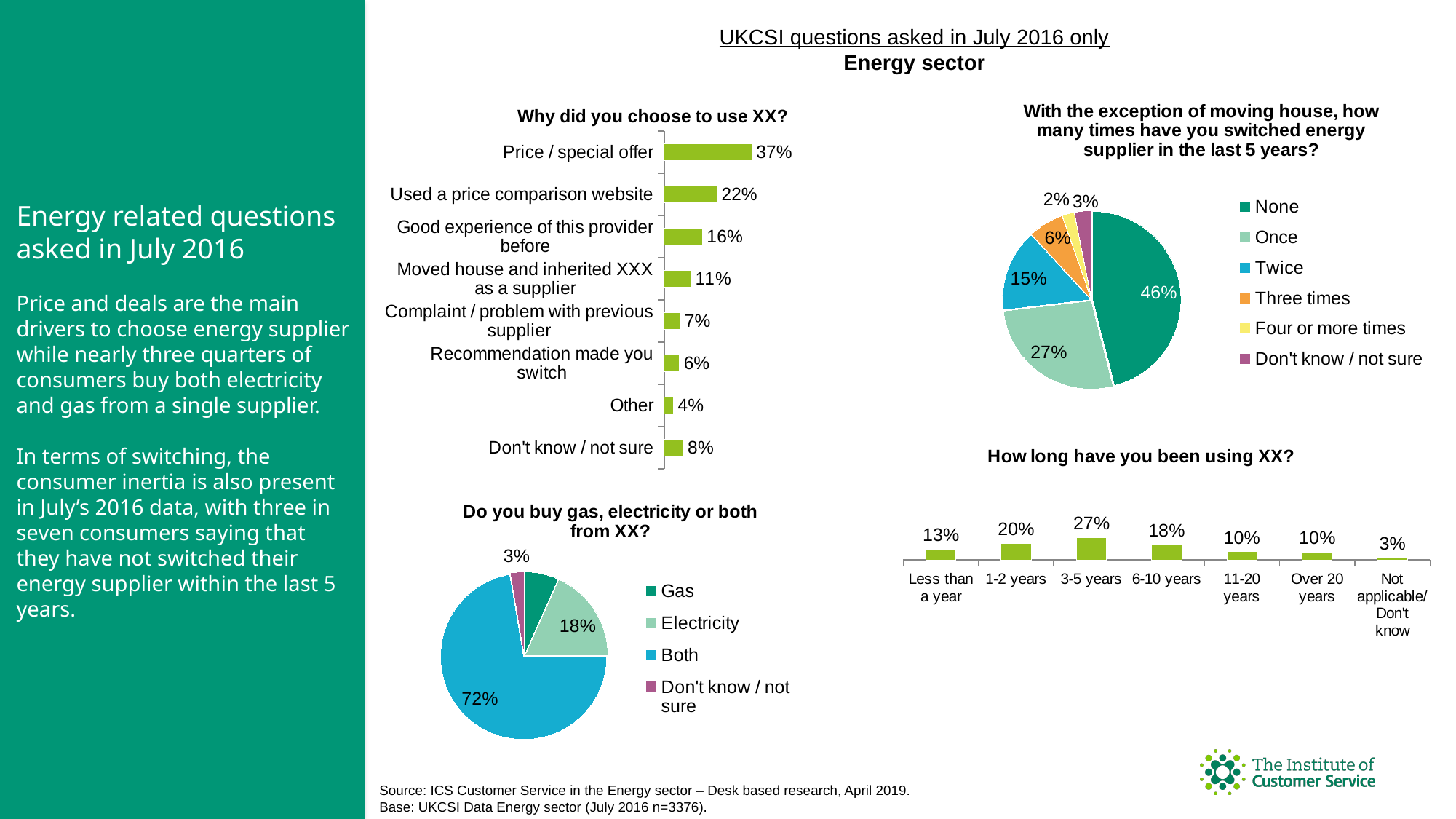
In the 'Do you buy gas, electricity or both from XX?' pie chart, what share is 'Both'? 72% In the 'Why did you choose to use XX?' chart, what percentage chose 'Price / special offer'? 37% In the 'Do you buy gas, electricity or both from XX?' pie chart, which is larger: 'Electricity' or 'Don't know / not sure'? Electricity In the 'Why did you choose to use XX?' chart, which reason has the lowest percentage? Other In the 'Why did you choose to use XX?' chart, what is the difference between 'Used a price comparison website' and 'Good experience of this provider before'? 6% In the pie chart about switching energy supplier, which category has the smallest share? Four or more times How many entries does the legend list in the pie chart about switching energy supplier in the last 5 years? 6 In the 'How long have you been using XX?' chart, what is the value for '1-2 years'? 20% How many categories are shown in the 'Why did you choose to use XX?' chart? 8 What type of chart is 'Why did you choose to use XX?'? Bar chart In the pie chart about how many times consumers have switched energy supplier in the last 5 years, what share is 'None'? 46% In the 'How long have you been using XX?' chart, which category has the highest value? 3-5 years